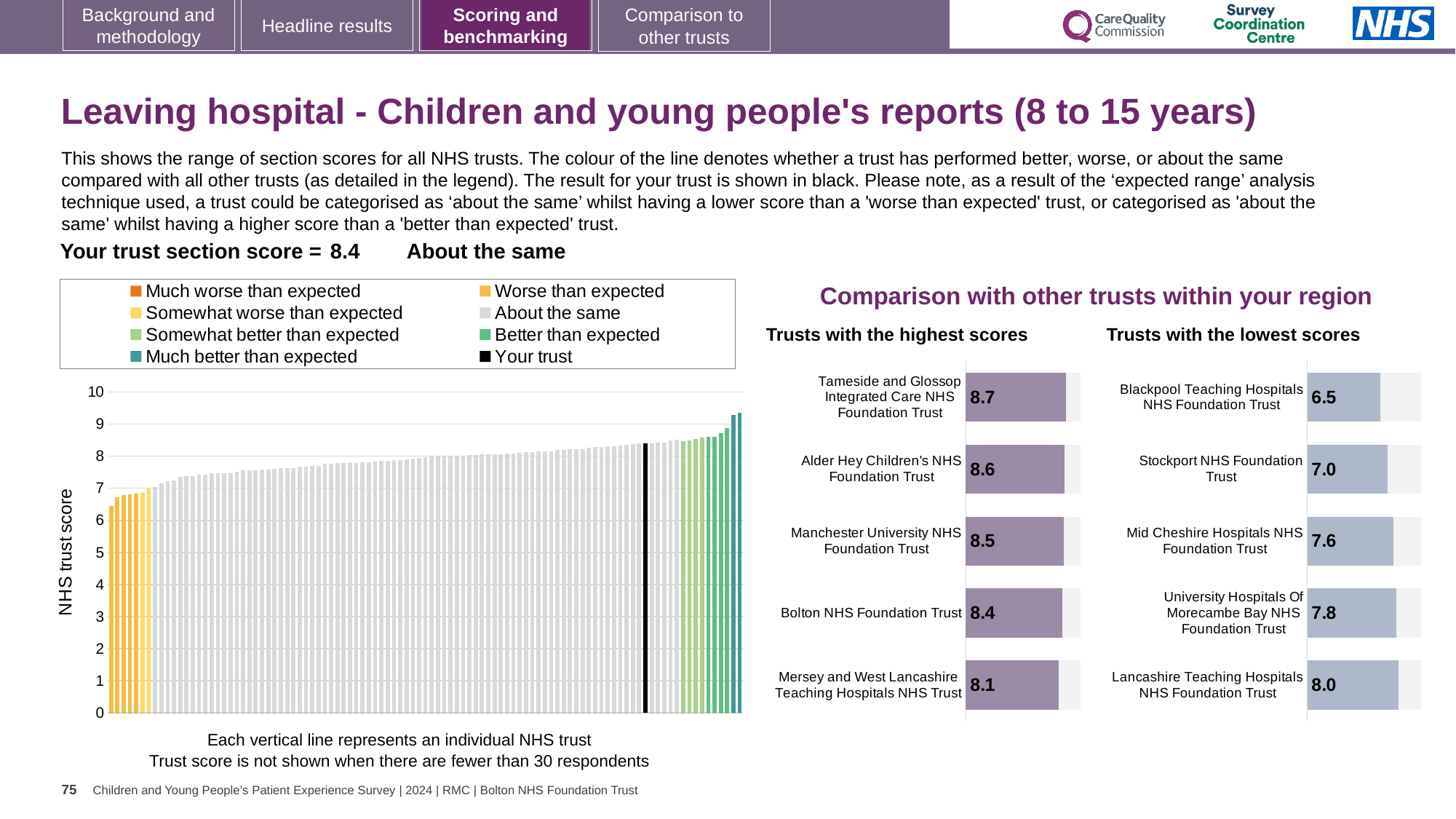
In the 'Trusts with the highest scores' chart, what is the score for Tameside and Glossop Integrated Care NHS Foundation Trust? 8.7 How many trusts are shown in the 'Trusts with the highest scores' chart? 5 In the 'Trusts with the lowest scores' chart, which has the higher score: Stockport NHS Foundation Trust or Mid Cheshire Hospitals NHS Foundation Trust? Mid Cheshire Hospitals NHS Foundation Trust In the main 'NHS trust score' chart, do the values rise or fall from left to right along the x axis? Rise In the 'Trusts with the highest scores' chart, what is the difference between the scores of Tameside and Glossop Integrated Care NHS Foundation Trust and Mersey and West Lancashire Teaching Hospitals NHS Trust? 0.6 In the main 'NHS trust score' chart, is the value of the leftmost (lowest) bar greater or less than 7? less In the 'Trusts with the lowest scores' chart, what is the score for Blackpool Teaching Hospitals NHS Foundation Trust? 6.5 How many entries does the legend of the main 'NHS trust score' chart list? 8 In the 'Trusts with the lowest scores' chart, what is the difference between the scores of Lancashire Teaching Hospitals NHS Foundation Trust and Blackpool Teaching Hospitals NHS Foundation Trust? 1.5 What kind of chart is the main 'NHS trust score' chart on the left? Bar chart In the 'Trusts with the highest scores' chart, which trust has the highest score? Tameside and Glossop Integrated Care NHS Foundation Trust In the 'Trusts with the lowest scores' chart, which trust has the lowest score? Blackpool Teaching Hospitals NHS Foundation Trust